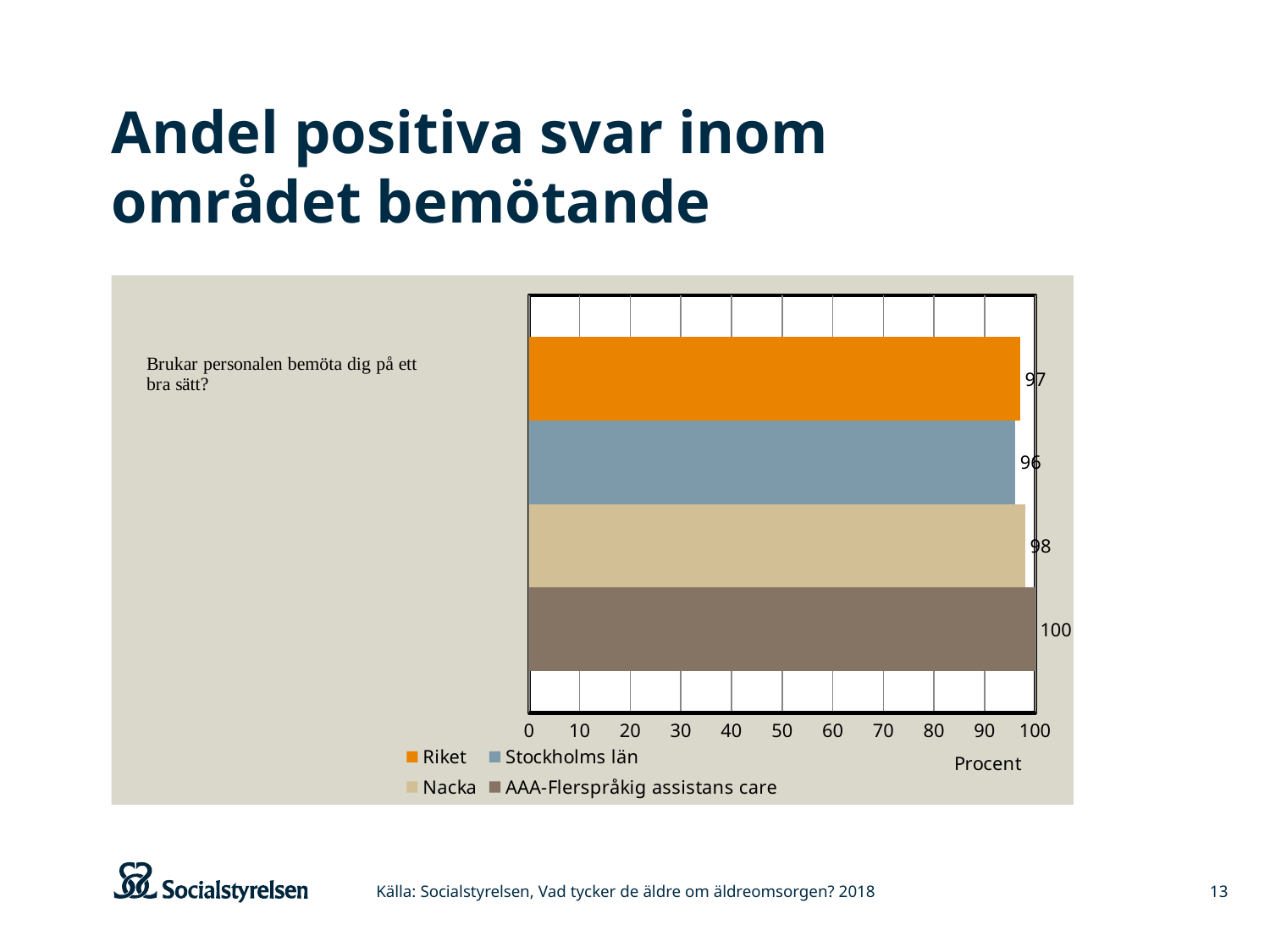
Which is larger, the value for Nacka or the value for Riket? Nacka How many series does the legend list? 4 What is the difference between the values for AAA-Flerspråkig assistans care and Stockholms län? 4 Which series has the lowest value? Stockholms län What is the value for Nacka? 98 What is the label of the x axis? Procent What kind of chart is shown on the slide? Bar chart What is the value for Riket? 97 What is the difference between the values for Nacka and Riket? 1 Which series has the highest value? AAA-Flerspråkig assistans care What is the value for Stockholms län? 96 What is the value for AAA-Flerspråkig assistans care? 100